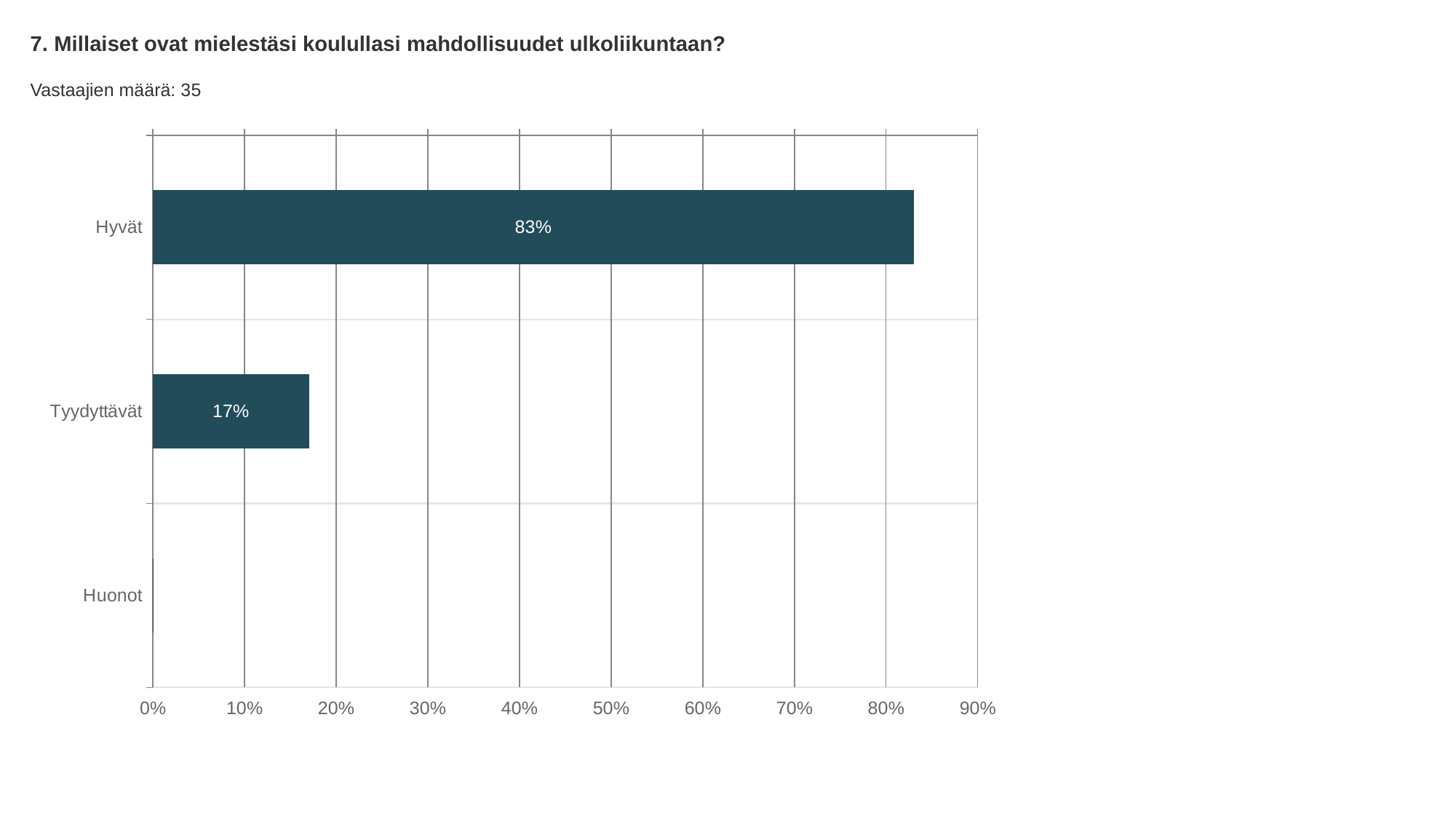
What is the difference between the values for Hyvät and Tyydyttävät? 66% What is the highest value shown on the x axis? 90% Which category has the highest value? Hyvät Which is larger, the value for Hyvät or the value for Tyydyttävät? Hyvät What is the value for Tyydyttävät? 17% How many categories are shown in the chart? 3 Is the value for Tyydyttävät greater or less than 20%? less What is the number of respondents (Vastaajien määrä) shown on the slide? 35 Is the value for Huonot greater or less than 10%? less What is the value for Hyvät? 83% What kind of chart is shown on the slide? bar chart Which category has the lowest value? Huonot